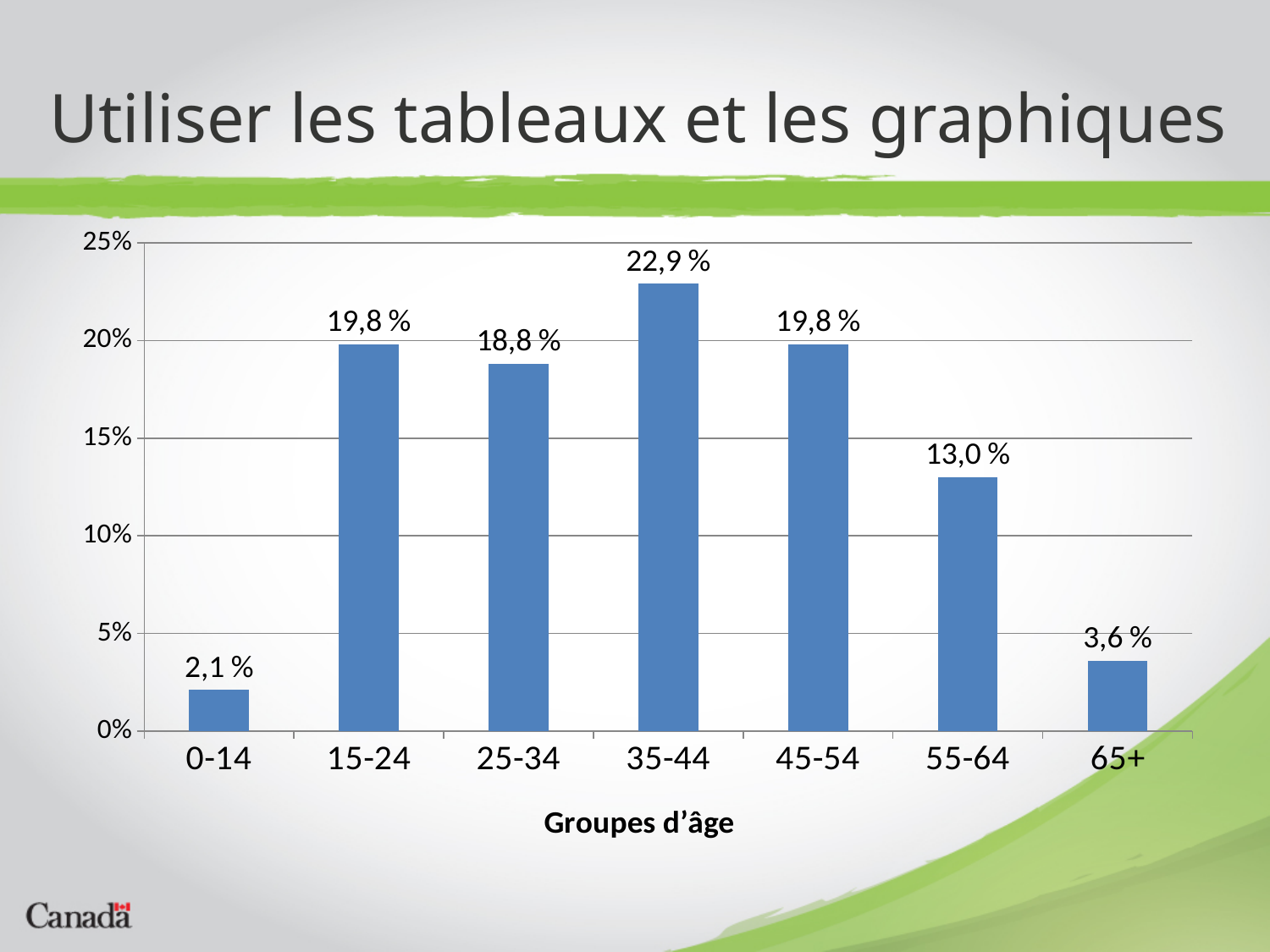
What is the value for the 0-14 age group? 2,1 % Which age group has the highest value? 35-44 What is the difference between the values for 35-44 and 55-64? 9,9 % What kind of chart is shown on the slide? bar chart How many age groups are shown on the x axis? 7 What is the x-axis title of the chart? Groupes d’âge What is the value for the 35-44 age group? 22,9 % Which age group has the lowest value? 0-14 What is the value for the 65+ age group? 3,6 % Which is larger, the value for 25-34 or the value for 45-54? 45-54 What is the value for the 55-64 age group? 13,0 % Is the value for 55-64 greater or less than 15%? less